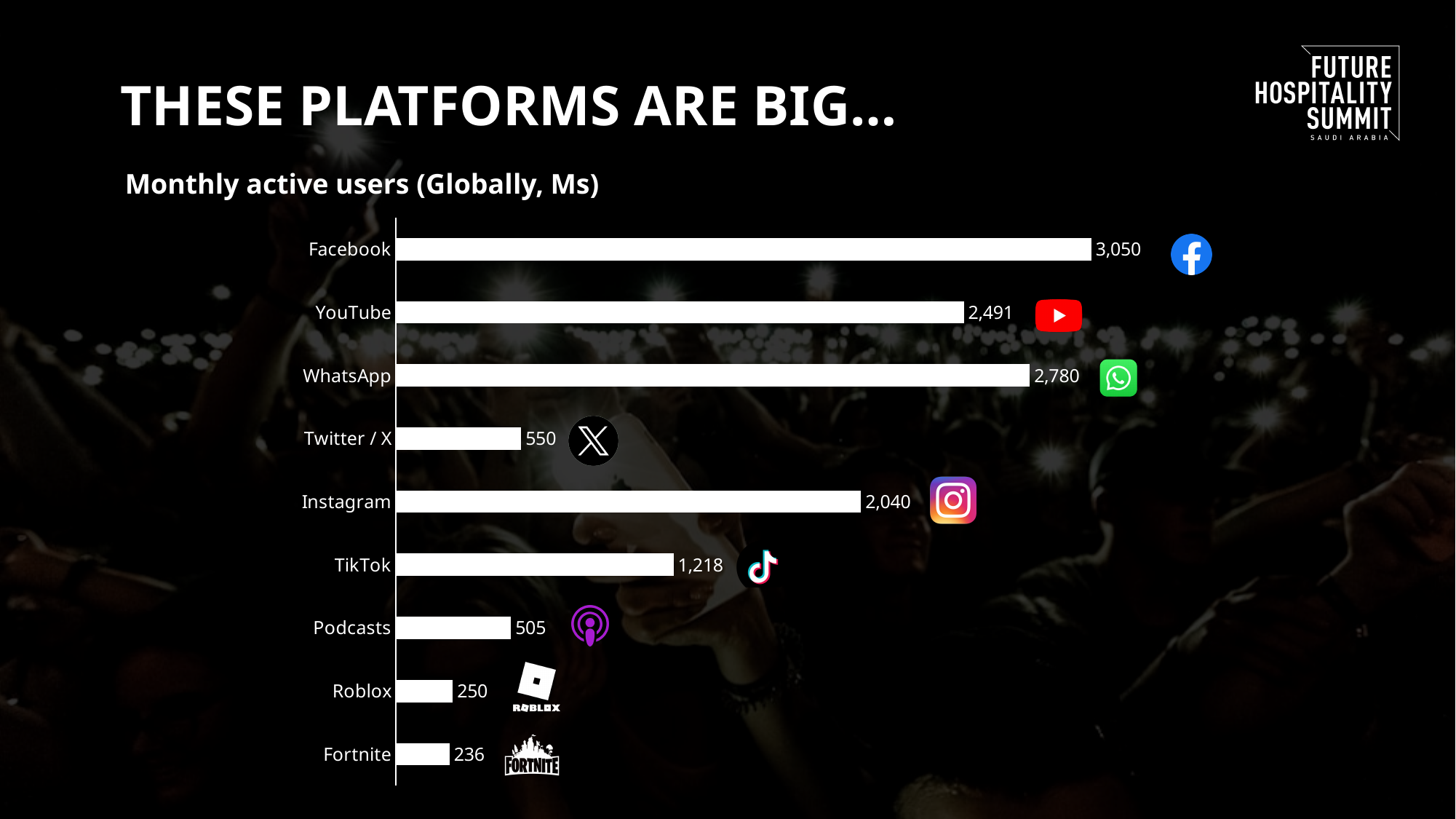
What is the subtitle describing the chart's measure? Monthly active users (Globally, Ms) What is the monthly active users value for Podcasts? 505 What type of chart is shown on the slide? Bar chart Which platform has the lowest monthly active users? Fortnite Which platform has the highest monthly active users? Facebook Which has more monthly active users, WhatsApp or YouTube? WhatsApp What is the monthly active users value for TikTok? 1,218 How many platforms are shown in the chart? 9 What is the difference in monthly active users between Instagram and TikTok? 822 What is the difference in monthly active users between WhatsApp and YouTube? 289 Which has more monthly active users, Twitter / X or Podcasts? Twitter / X What is the monthly active users value for Facebook? 3,050